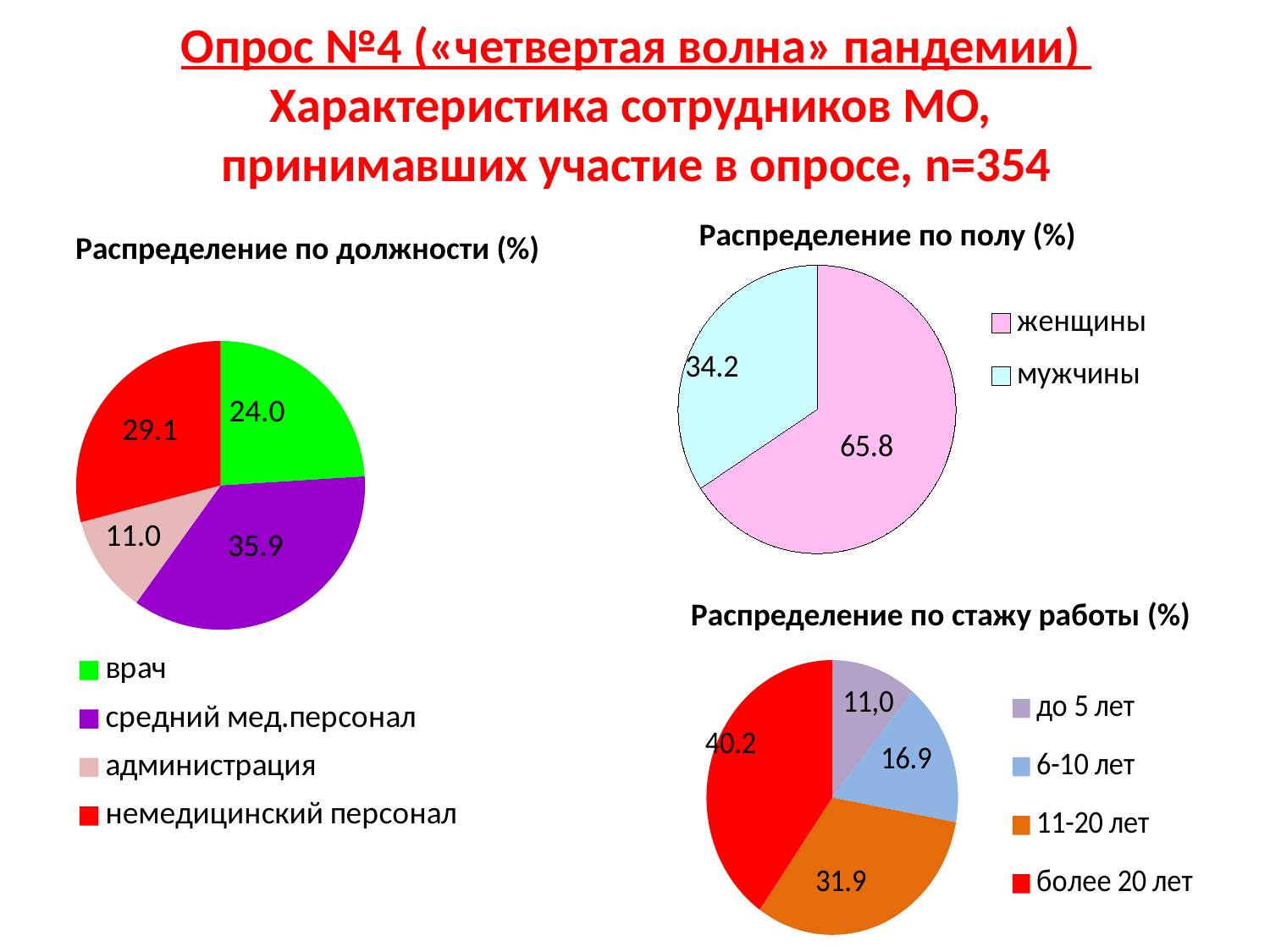
In the chart 'Распределение по должности (%)', what is the difference between 'немедицинский персонал' and 'врач'? 5.1 In the chart 'Распределение по должности (%)', what is the value for 'средний мед.персонал'? 35.9 In the chart 'Распределение по стажу работы (%)', what is the value for 'до 5 лет'? 11,0 In the chart 'Распределение по должности (%)', how many categories does the legend list? 4 In the chart 'Распределение по должности (%)', which category has the smallest share? администрация In the chart 'Распределение по полу (%)', which is larger, 'женщины' or 'мужчины'? женщины In the chart 'Распределение по стажу работы (%)', which category has the largest share? более 20 лет In the chart 'Распределение по стажу работы (%)', what is the value for '6-10 лет'? 16.9 What type of chart is 'Распределение по стажу работы (%)'? pie chart In the chart 'Распределение по полу (%)', what is the value for 'мужчины'? 34.2 In the chart 'Распределение по должности (%)', what colour is the slice for 'врач'? green In the chart 'Распределение по полу (%)', what is the difference between 'женщины' and 'мужчины'? 31.6